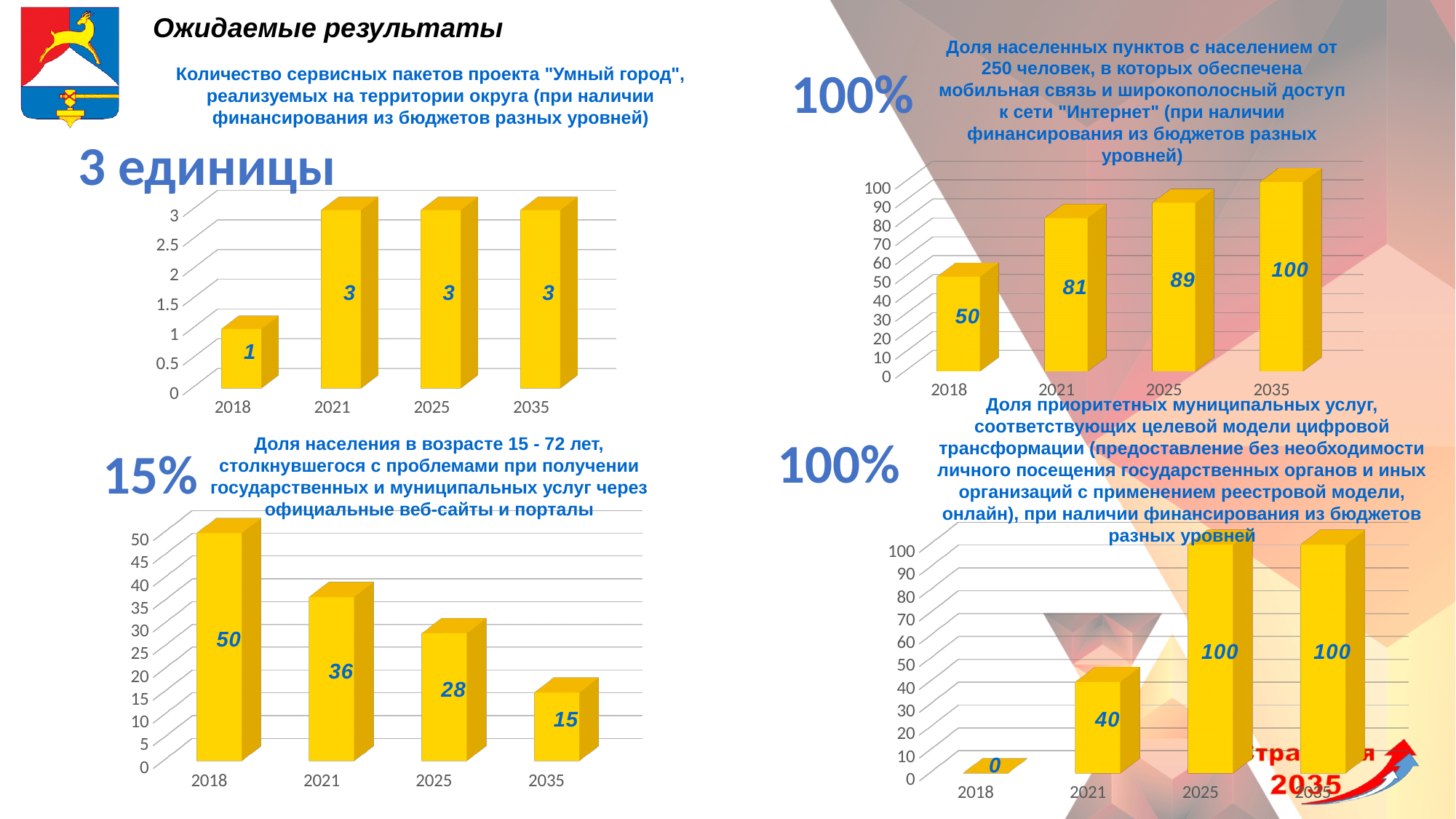
In the bottom-right chart (share of priority municipal services), which year has the lowest value? 2018 In the bottom-left chart (share of population aged 15-72 facing problems with services), what is the value for 2025? 28 In the bottom-right chart (share of priority municipal services), what is the value for 2021? 40 In the top-right chart (share of settlements with mobile and broadband access), what is the value for 2021? 81 In the top-left chart (number of Smart City service packages), what is the value for 2025? 3 What type of chart is the top-left chart (number of Smart City service packages)? bar chart In the bottom-left chart (share of population aged 15-72 facing problems with services), do the values rise or fall from 2018 to 2035? fall In the bottom-left chart (share of population aged 15-72 facing problems with services), what is the difference between the 2018 and 2021 values? 14 How many years (categories) are shown on the x axis of the bottom-right chart (share of priority municipal services)? 4 In the top-right chart (share of settlements with mobile and broadband access), which year has the lowest value? 2018 In the top-right chart (share of settlements with mobile and broadband access), what is the difference between the 2035 and 2025 values? 11 In the top-left chart (number of Smart City service packages), what is the value for 2018? 1